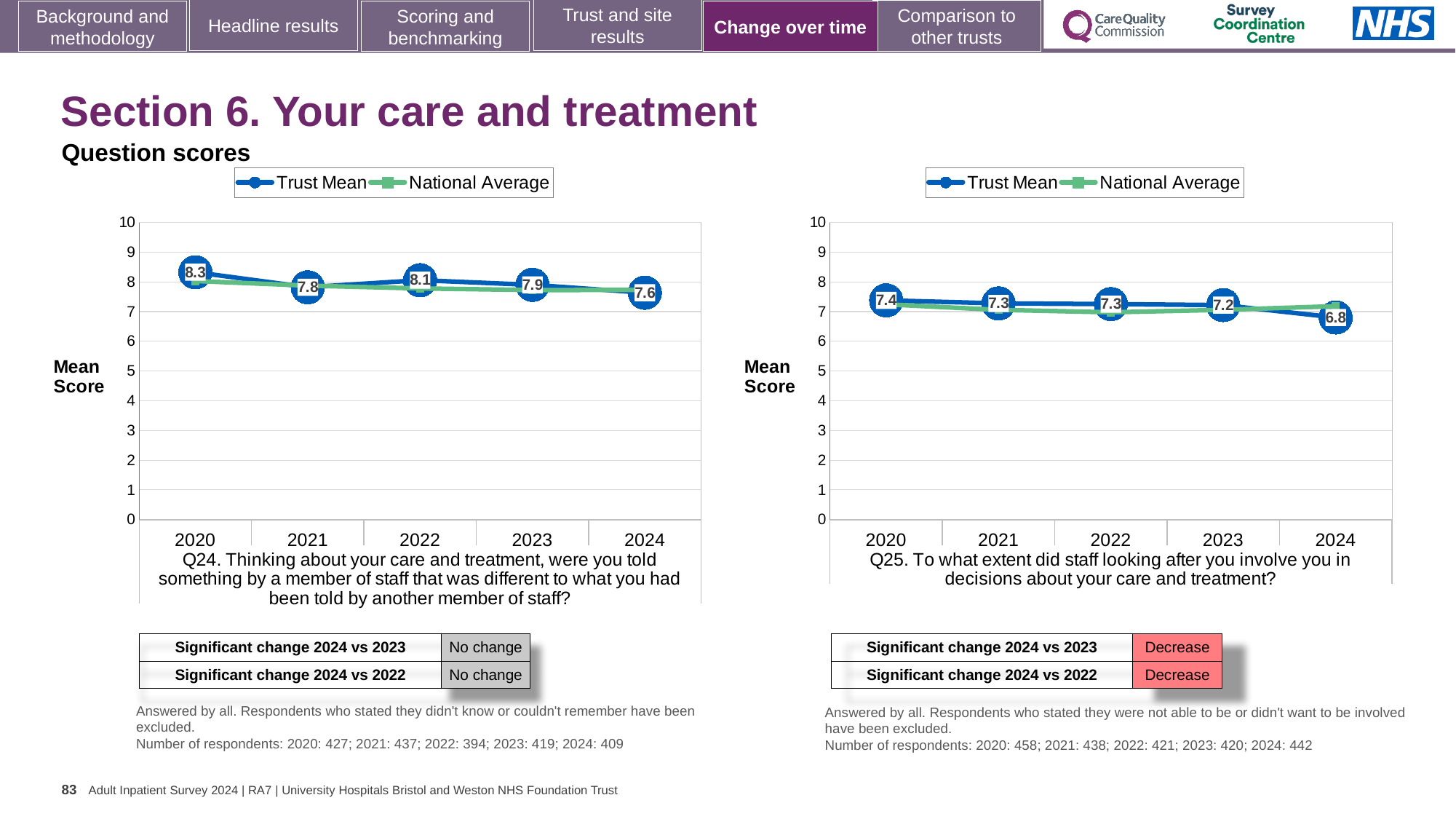
In the Q24 chart, which year has the highest Trust Mean score? 2020 In the Q24 chart, is the Trust Mean score higher in 2022 or in 2021? 2022 In the Q25 chart, what is the Trust Mean score for 2024? 6.8 In the Q24 chart, what is the Trust Mean score for 2024? 7.6 In the Q24 chart, what is the difference between the Trust Mean scores for 2020 and 2024? 0.7 How many years are plotted on the x axis of the Q25 chart? 5 In the Q25 chart, which year has the lowest Trust Mean score? 2024 In the Q24 chart, what is the Trust Mean score for 2020? 8.3 In the Q25 chart, what is the difference between the Trust Mean scores for 2023 and 2024? 0.4 In the Q25 chart, what is the Trust Mean score for 2020? 7.4 How many series does the legend of the Q24 chart list? 2 What type of chart is used for Q25? Line chart